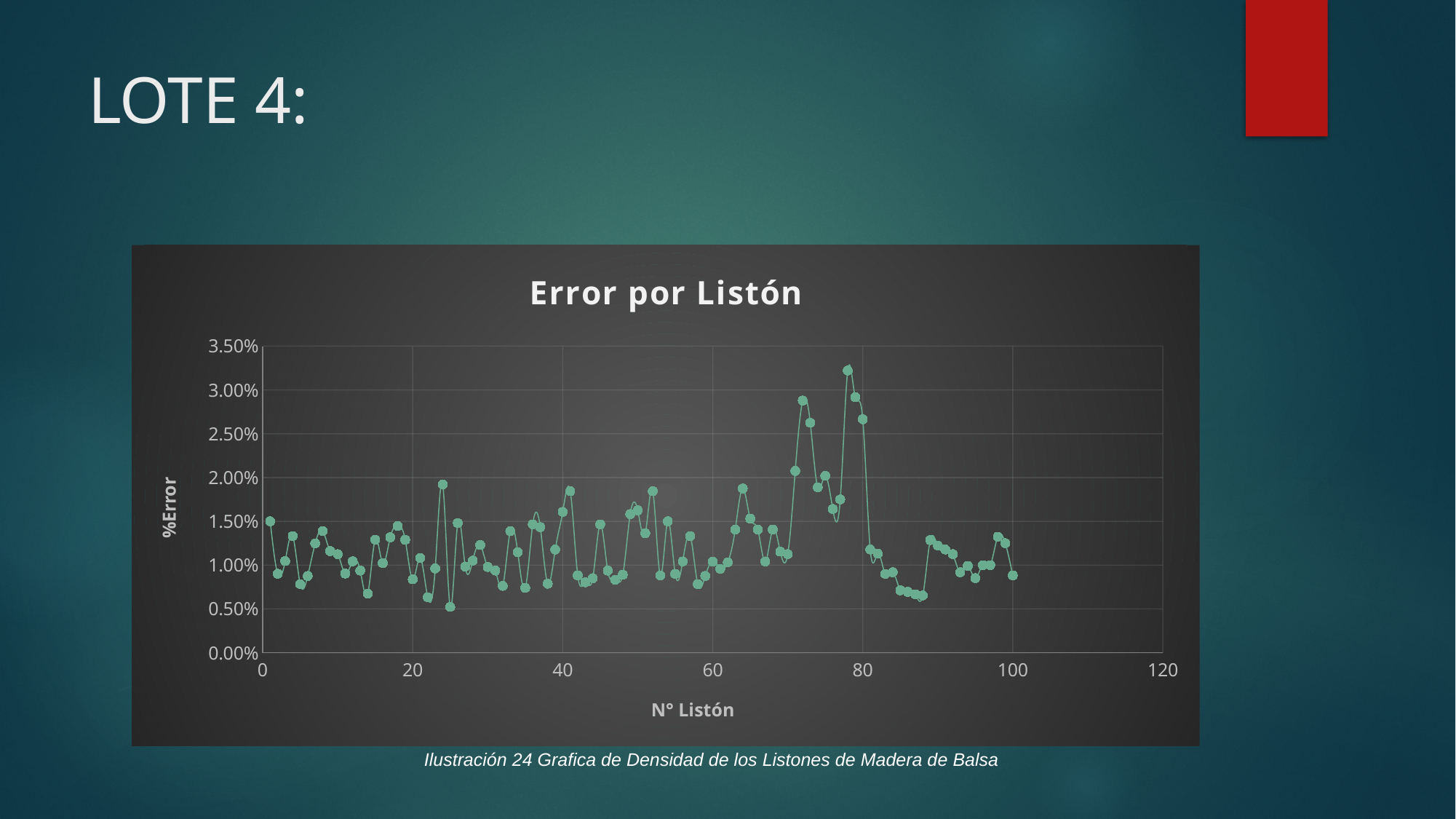
Which is larger, the value at N° Listón 78 or the value at N° Listón 100? N° Listón 78 Between N° Listón 80 and N° Listón 100, do the values generally rise or fall? fall Is the value for N° Listón 60 greater or less than 1.50%? less Is the lowest value plotted on the chart greater or less than 1.00%? less Is the highest value plotted on the chart greater or less than 3.00%? greater What is the title of the chart? Error por Listón What kind of chart is shown on the slide? Line chart with markers What is the label of the x axis of the chart? N° Listón